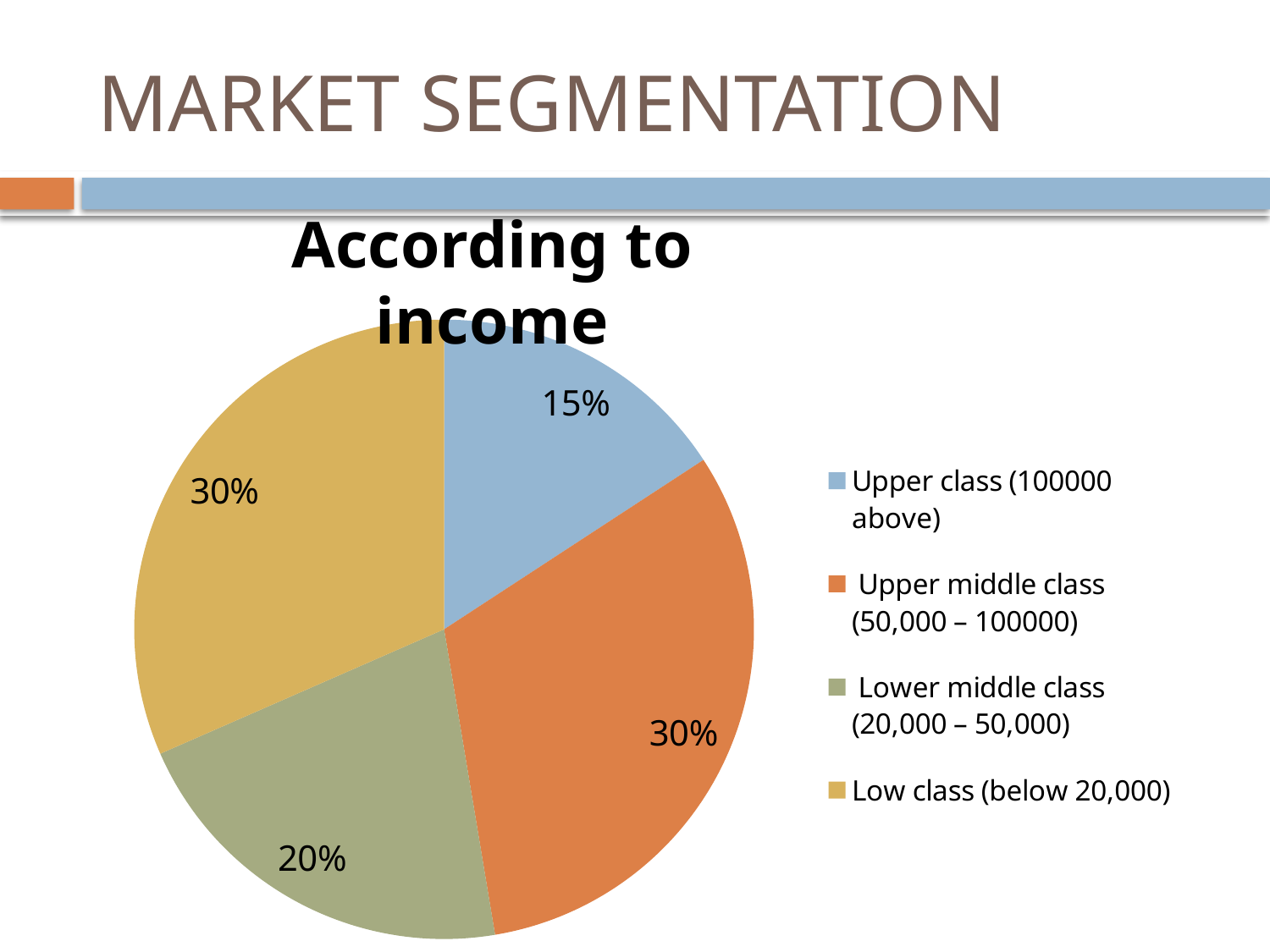
Which slice is larger, Upper middle class (50,000 – 100000) or Lower middle class (20,000 – 50,000)? Upper middle class (50,000 – 100000) What share of the pie does the Upper class (100000 above) slice represent? 15% What share of the pie does the Upper middle class (50,000 – 100000) slice represent? 30% What is the title of the chart? According to income What colour is the Low class (below 20,000) slice? yellow What share of the pie does the Low class (below 20,000) slice represent? 30% What share of the pie does the Lower middle class (20,000 – 50,000) slice represent? 20% What type of chart is shown on the slide? pie chart How many slices does the pie chart have? 4 How many entries does the legend list? 4 What is the difference in percentage points between the Low class (below 20,000) slice and the Upper class (100000 above) slice? 15 Which income class has the smallest slice of the pie? Upper class (100000 above)